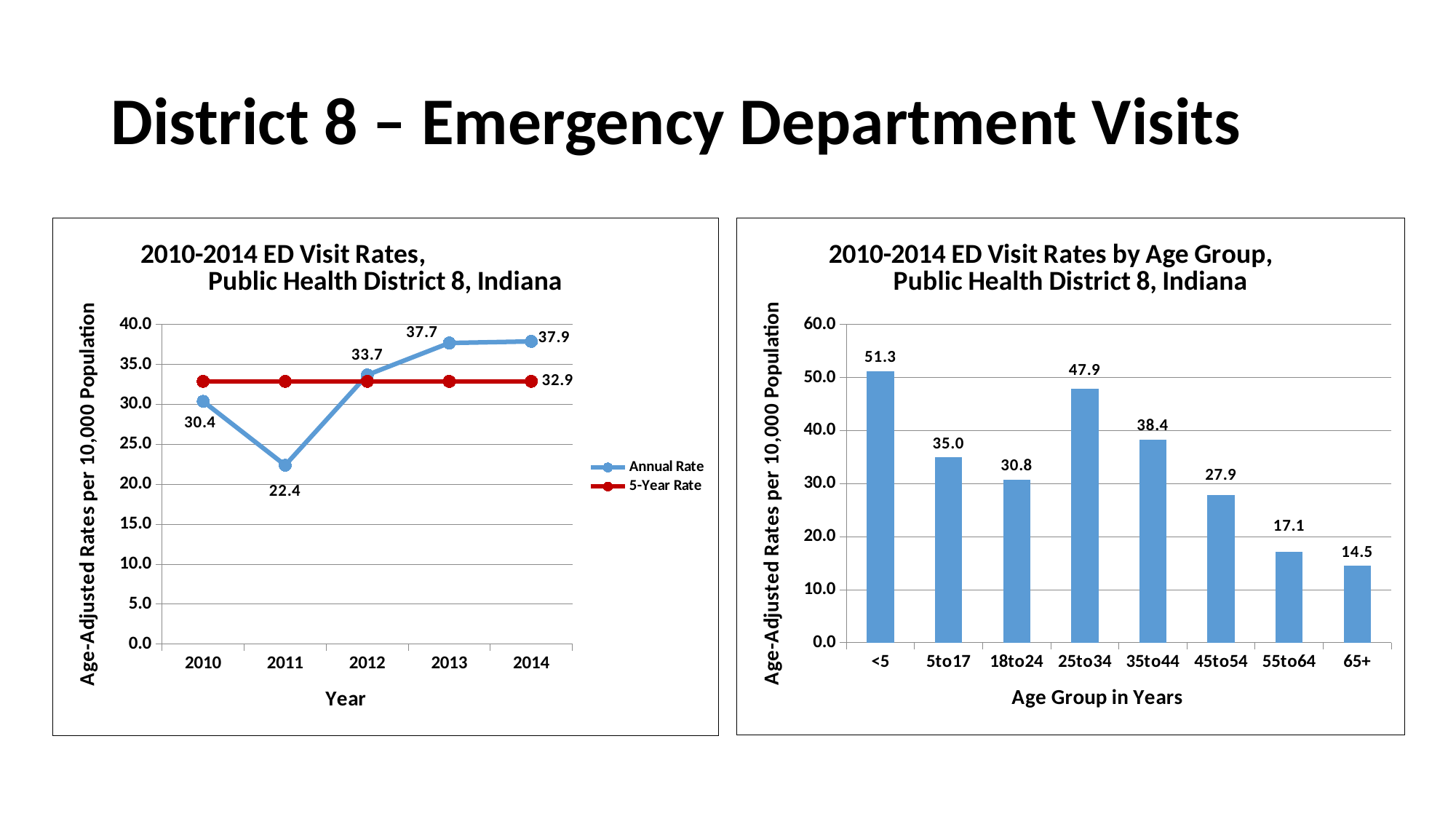
In the left chart (2010-2014 ED Visit Rates), how many series does the legend list? 2 In the right chart (ED Visit Rates by Age Group), which age group has the lowest rate? 65+ In the left chart (2010-2014 ED Visit Rates), does the Annual Rate rise or fall from 2011 to 2014? rise In the right chart (ED Visit Rates by Age Group), which age group has the highest rate? <5 In the left chart (2010-2014 ED Visit Rates), which year has the highest Annual Rate? 2014 In the left chart (2010-2014 ED Visit Rates), what is the Annual Rate for 2011? 22.4 In the right chart (ED Visit Rates by Age Group), how many age groups are shown? 8 In the right chart (ED Visit Rates by Age Group), what is the rate for the 35to44 age group? 38.4 In the left chart (2010-2014 ED Visit Rates), what is the 5-Year Rate? 32.9 What kind of chart is the right chart (ED Visit Rates by Age Group)? bar chart In the left chart (2010-2014 ED Visit Rates), what is the difference between the Annual Rate in 2014 and in 2010? 7.5 In the left chart (2010-2014 ED Visit Rates), which year has the lowest Annual Rate? 2011